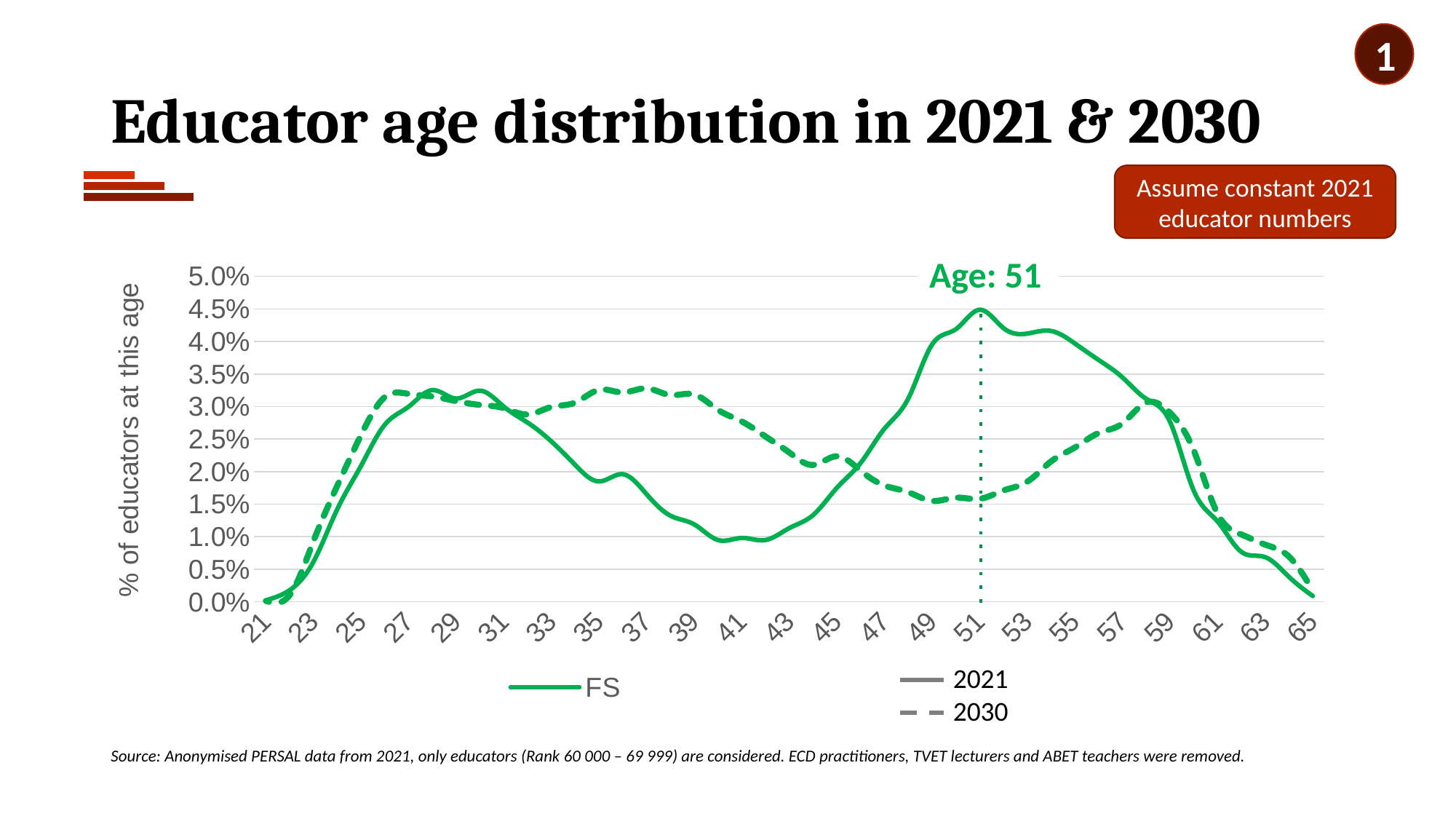
At age 51, which line is higher, 2021 or 2030? 2021 Is the 2021 value at age 51 greater or less than 4.0%? greater At which age does the 2021 (solid) line reach its highest value? 51 According to the legend, which year does the dashed line represent? 2030 Is the 2030 value at age 35 greater or less than 3.0%? greater At age 37, which line is higher, 2021 or 2030? 2030 What kind of chart is shown on the slide? line chart Is the 2021 value at age 41 greater or less than 1.5%? less How many years (series) does the legend list for the lines? 2 What is the title of the slide's chart? Educator age distribution in 2021 & 2030 Between ages 51 and 65, does the 2021 line rise or fall? fall